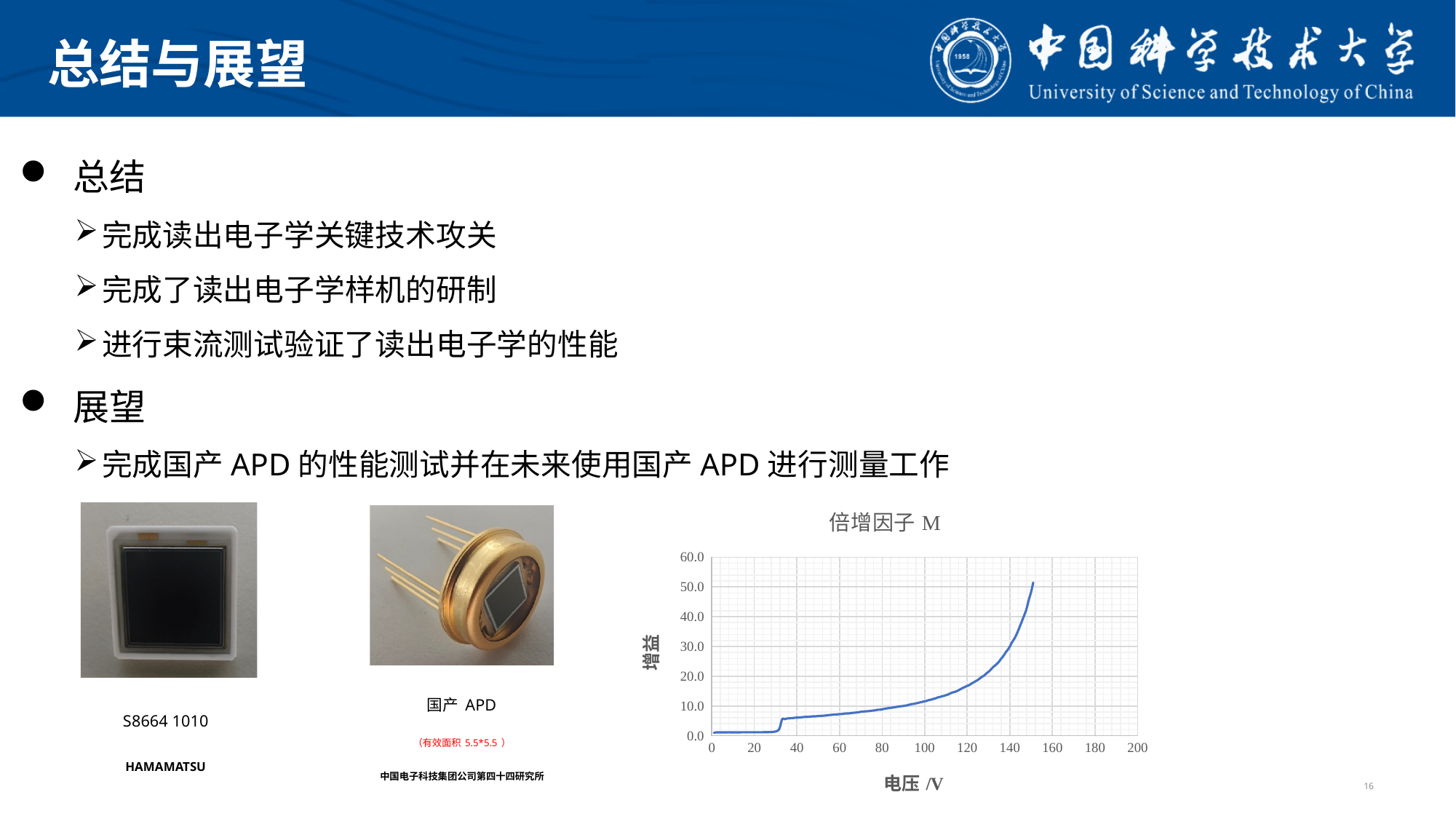
Is the gain at a voltage of 100 V greater or less than 10.0? greater Is the gain at a voltage of 140 V greater or less than 20.0? greater Is the gain at a voltage of 60 V greater or less than 10.0? less What is the title of the chart on the slide? 倍增因子 M What kind of chart is shown on the slide? line chart What is the highest tick value shown on the x axis of the chart? 200 Does the gain (增益) rise or fall as the voltage increases along the x axis? rise What is the label of the x axis of the chart? 电压 /V